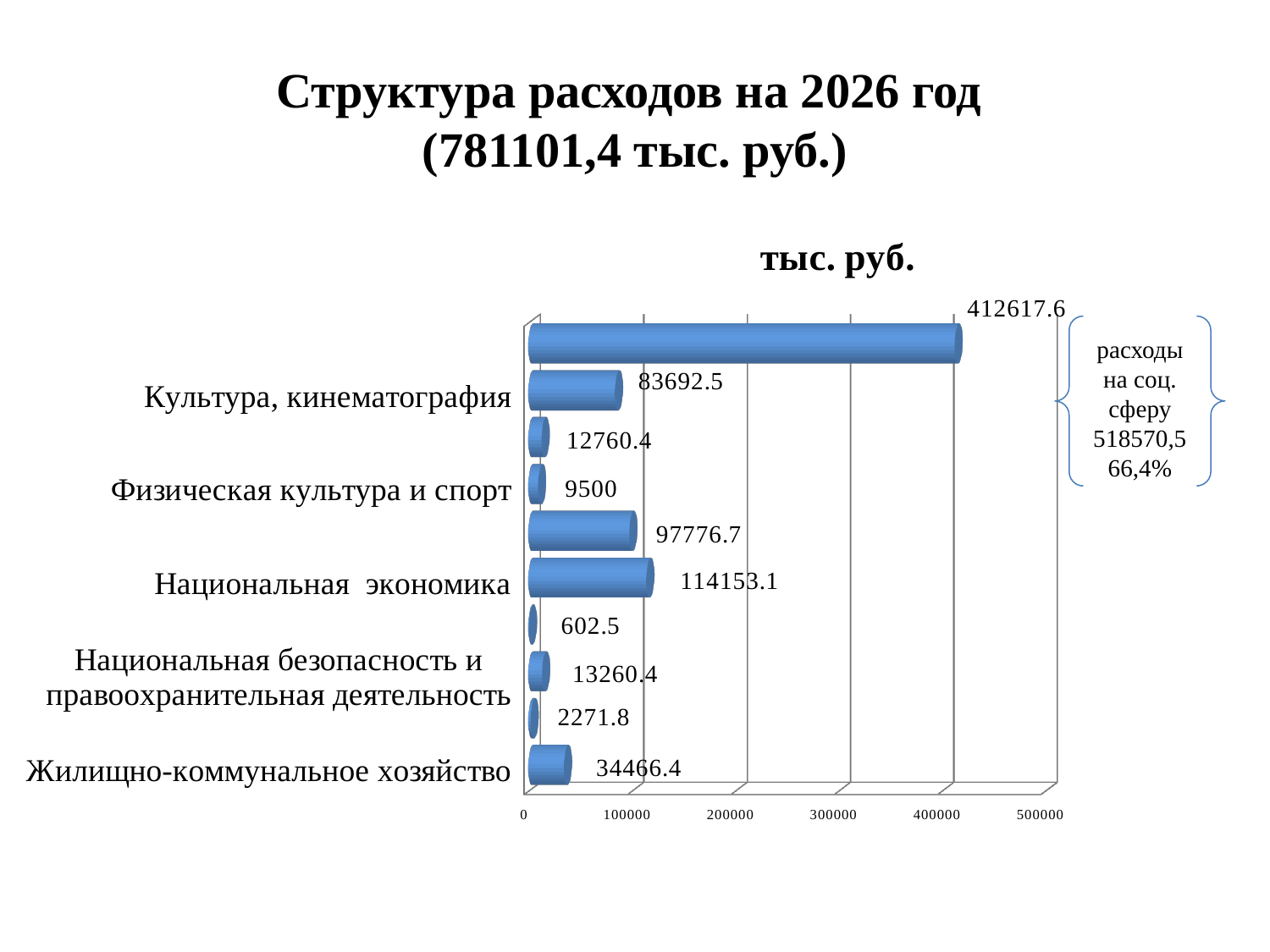
What is the largest value shown on the chart? 412617.6 What is the title of the chart? тыс. руб. What is the difference between the values for Национальная экономика and Культура, кинематография? 30460.6 What is the value for Национальная экономика? 114153.1 How many bars are plotted on the chart? 10 What is the value for Культура, кинематография? 83692.5 Which is larger, the value for Жилищно-коммунальное хозяйство or the value for Физическая культура и спорт? Жилищно-коммунальное хозяйство What is the smallest value shown on the chart? 602.5 What is the value for Жилищно-коммунальное хозяйство? 34466.4 What kind of chart is shown on the slide? Bar chart What is the value for Физическая культура и спорт? 9500 What is the value for Национальная безопасность и правоохранительная деятельность? 13260.4